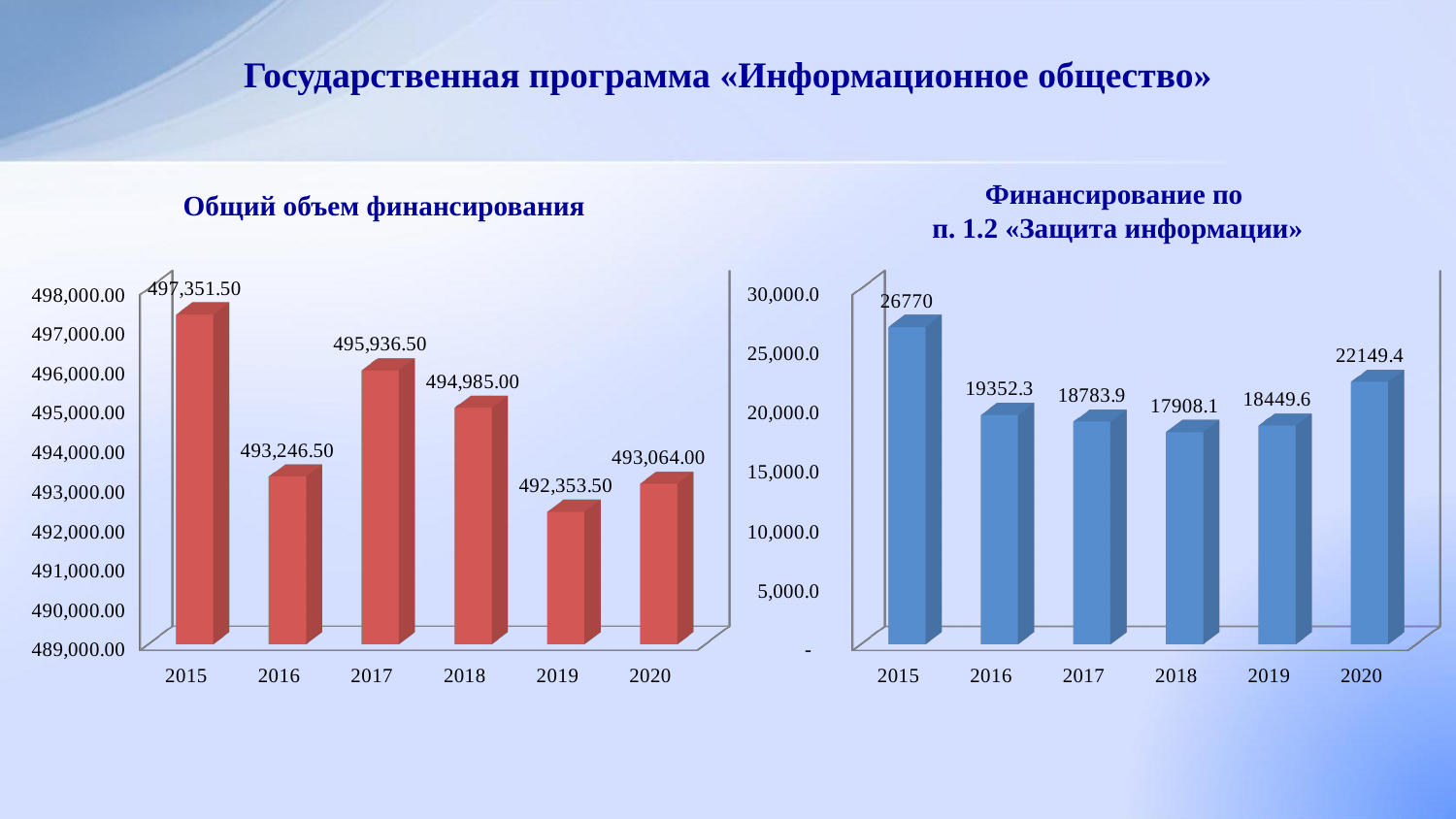
In the chart titled «Финансирование по п. 1.2 «Защита информации»», what is the value for 2019? 18449.6 In the chart titled «Финансирование по п. 1.2 «Защита информации»», what is the difference between the values for 2015 and 2018? 8861.9 In the chart titled «Общий объем финансирования», which is larger, the value for 2016 or the value for 2020? 2016 How many years are shown on the x axis of the chart titled «Финансирование по п. 1.2 «Защита информации»»? 6 In the chart titled «Общий объем финансирования», what is the difference between the values for 2015 and 2019? 4,998.00 In the chart titled «Общий объем финансирования», what is the value for 2017? 495,936.50 In the chart titled «Финансирование по п. 1.2 «Защита информации»», is the value for 2020 greater or less than 20,000.0? greater In the chart titled «Общий объем финансирования», which year has the highest value? 2015 What kind of chart is the chart titled «Общий объем финансирования»? Bar chart What colour are the bars in the chart titled «Финансирование по п. 1.2 «Защита информации»»? Blue In the chart titled «Общий объем финансирования», which year has the lowest value? 2019 In the chart titled «Финансирование по п. 1.2 «Защита информации»», which year has the lowest value? 2018